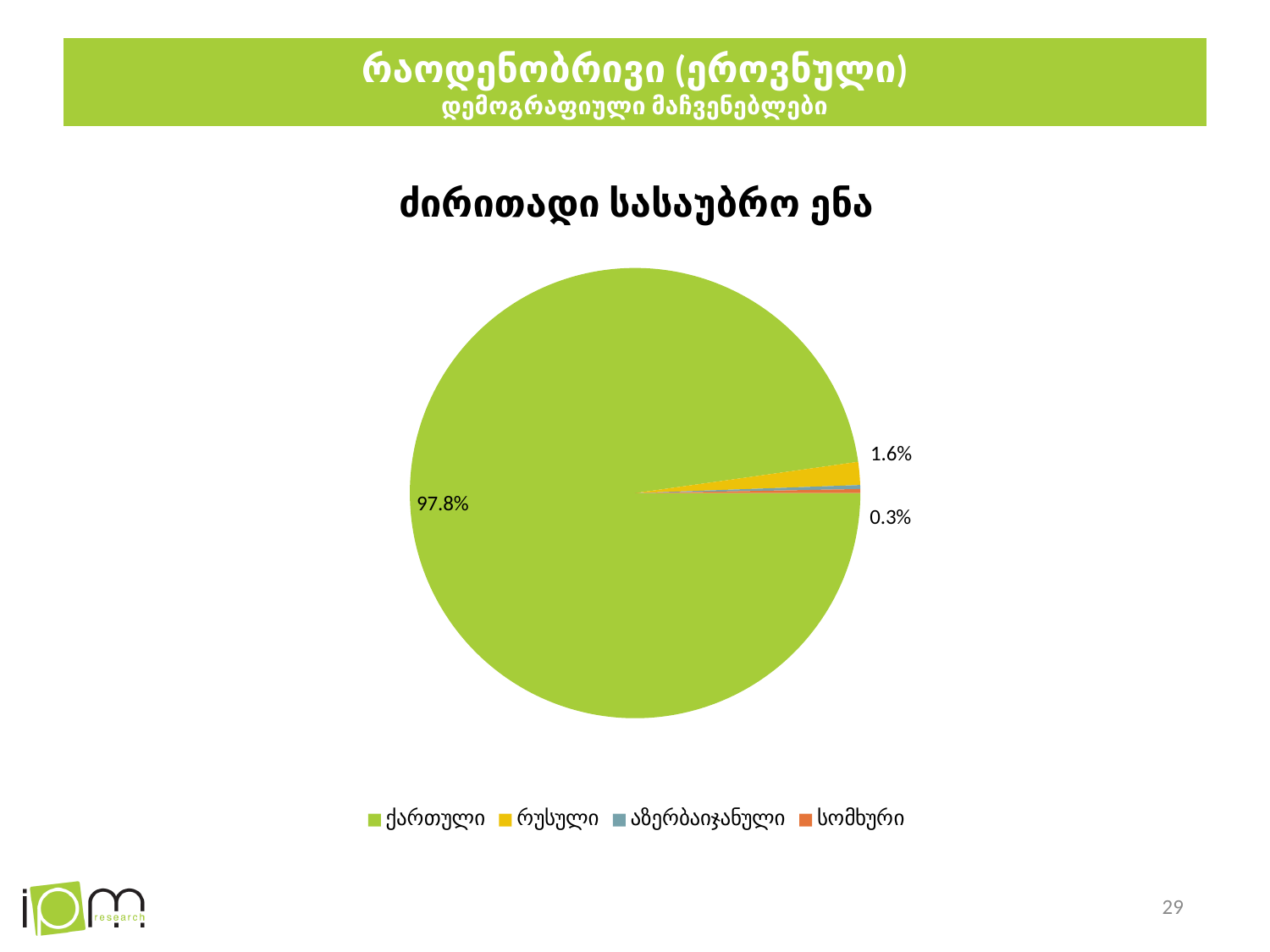
Which category has the largest slice of the pie? ქართული What type of chart is shown on the slide? pie chart What is the difference between the values for ქართული and რუსული? 96.2 percentage points What is the value shown for რუსული? 1.6% What colour is the slice for ქართული? green How many categories does the legend list? 4 What share of the pie does ქართული account for? 97.8% What is the title of the chart? ძირითადი სასაუბრო ენა Which is larger, the slice for ქართული or the slice for რუსული? ქართული